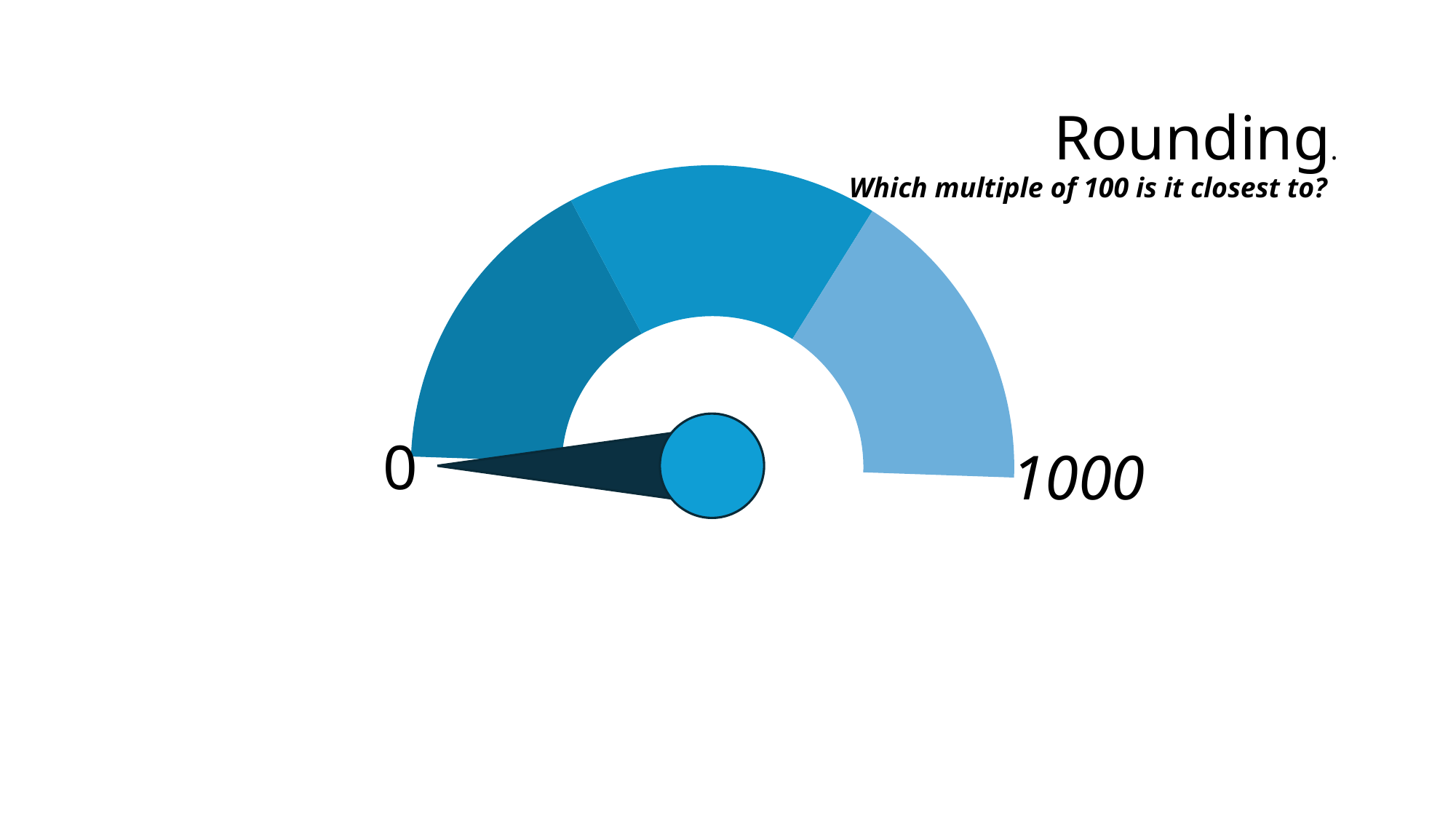
Is the value indicated by the needle greater or less than 500? less What is the highest value labelled on the gauge scale? 1000 How many coloured segments make up the gauge arc? 3 What question is written beneath the chart title? Which multiple of 100 is it closest to? Which labelled end of the gauge is the needle pointing to? 0 What is the lowest value labelled on the gauge scale? 0 What kind of chart is shown on the slide? gauge chart What is the title of the chart on the slide? Rounding.